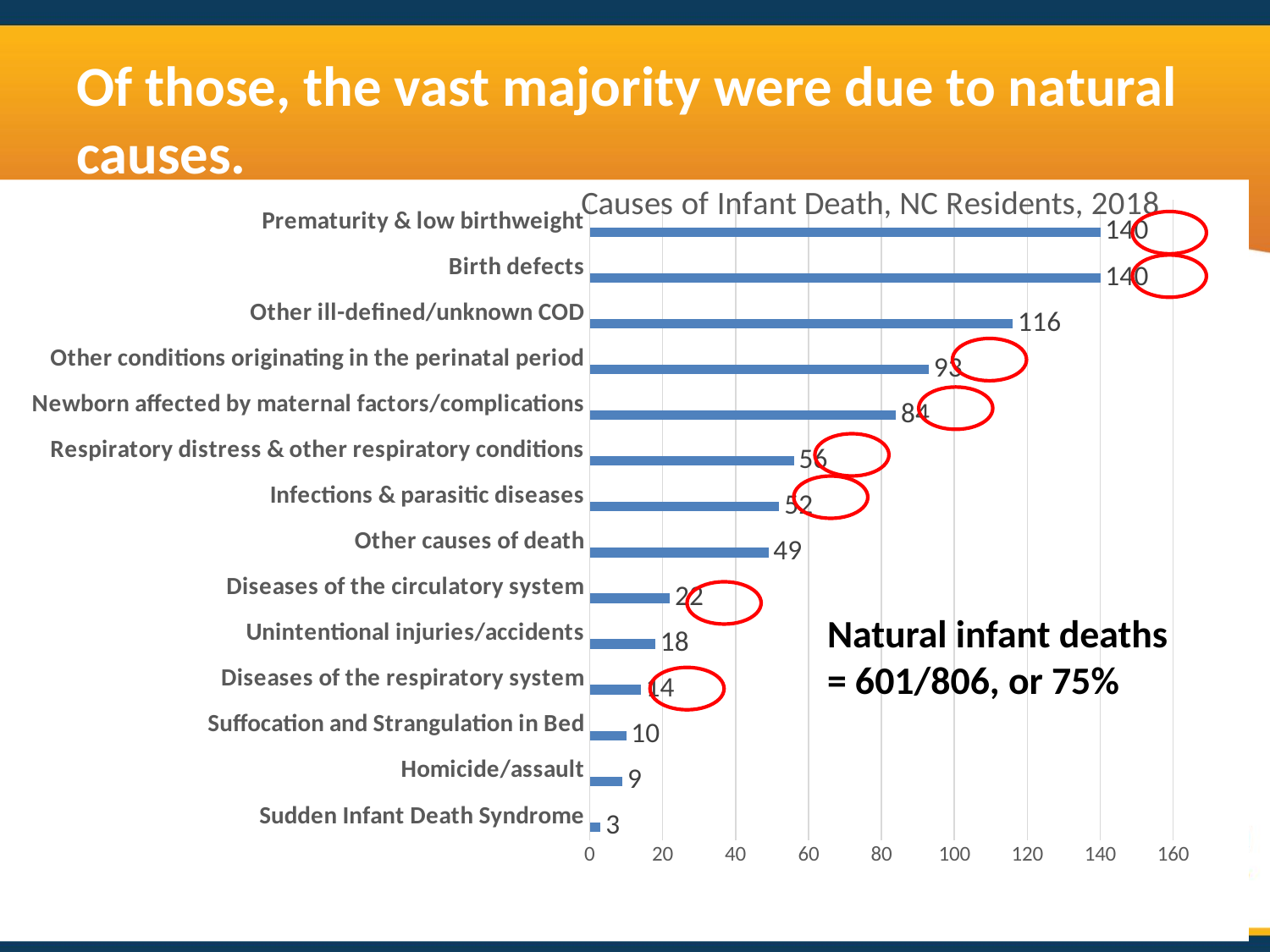
Is the value for Other conditions originating in the perinatal period greater or less than 80? greater What is the title of the chart? Causes of Infant Death, NC Residents, 2018 What type of chart is shown on the slide? bar chart What is the value for Birth defects? 140 Which is larger, the value for Unintentional injuries/accidents or the value for Suffocation and Strangulation in Bed? Unintentional injuries/accidents Which cause has the lowest value in the chart? Sudden Infant Death Syndrome How many causes of infant death are listed in the chart? 14 What is the value for Other ill-defined/unknown COD? 116 What is the value for Sudden Infant Death Syndrome? 3 What is the difference between the values for Other ill-defined/unknown COD and Other causes of death? 67 Is the value for Respiratory distress & other respiratory conditions greater or less than 60? less What is the value for Other causes of death? 49